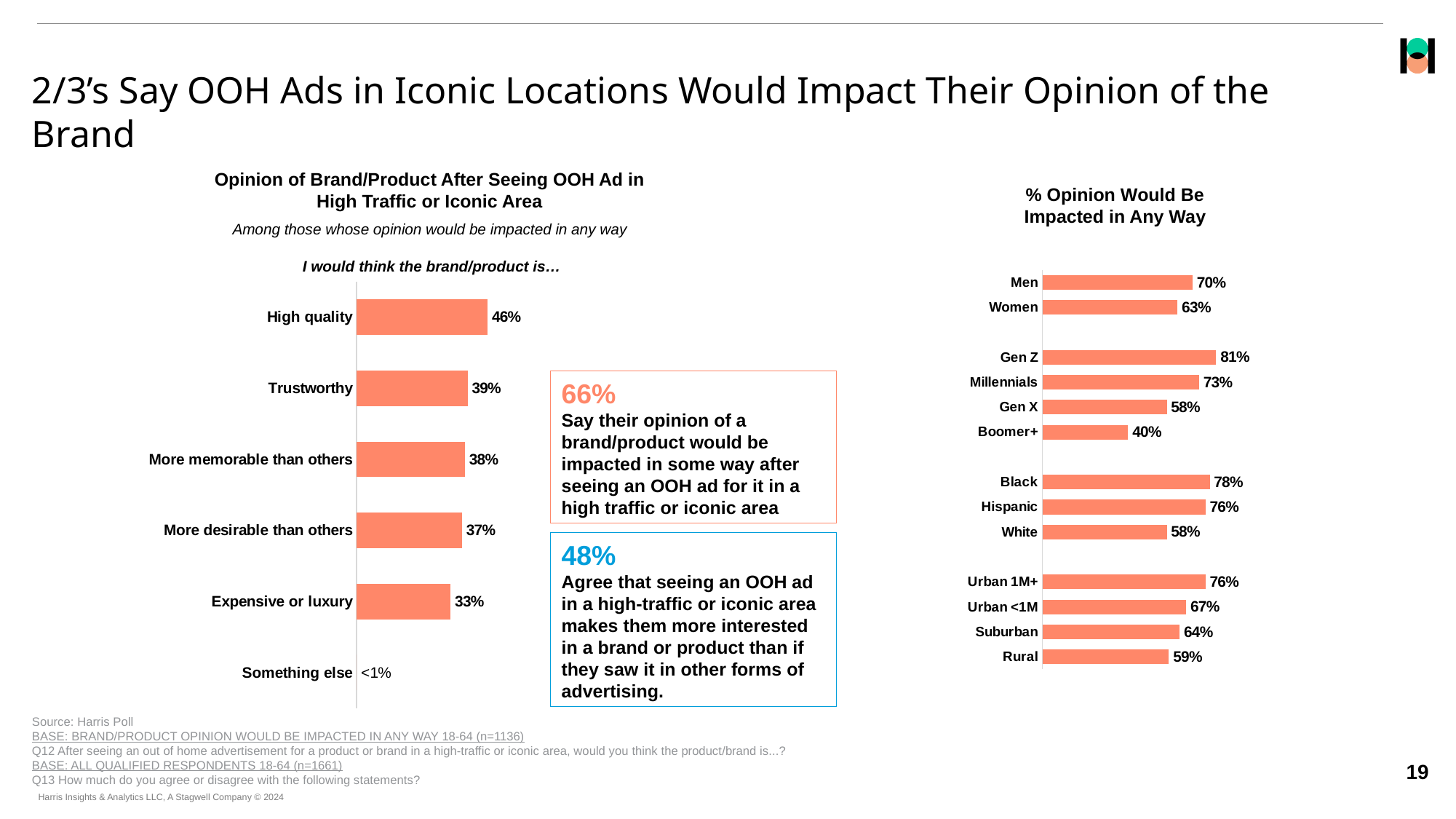
In the left chart 'Opinion of Brand/Product After Seeing OOH Ad in High Traffic or Iconic Area', how many categories are shown? 6 In the left chart 'Opinion of Brand/Product After Seeing OOH Ad in High Traffic or Iconic Area', which category has the highest value? High quality In the right chart '% Opinion Would Be Impacted in Any Way', what is the difference between 'Black' and 'White'? 20% In the right chart '% Opinion Would Be Impacted in Any Way', which is larger, 'Men' or 'Women'? Men In the right chart '% Opinion Would Be Impacted in Any Way', what is the value for 'Rural'? 59% In the left chart 'Opinion of Brand/Product After Seeing OOH Ad in High Traffic or Iconic Area', what is the difference between 'Trustworthy' and 'Expensive or luxury'? 6% In the left chart 'Opinion of Brand/Product After Seeing OOH Ad in High Traffic or Iconic Area', what is the value for 'Expensive or luxury'? 33% In the right chart '% Opinion Would Be Impacted in Any Way', what is the value for 'Gen Z'? 81% In the right chart '% Opinion Would Be Impacted in Any Way', which category has the lowest value? Boomer+ What type of chart is the right chart '% Opinion Would Be Impacted in Any Way'? Bar chart In the right chart '% Opinion Would Be Impacted in Any Way', how many categories are shown? 13 In the left chart 'Opinion of Brand/Product After Seeing OOH Ad in High Traffic or Iconic Area', what is the value for 'High quality'? 46%